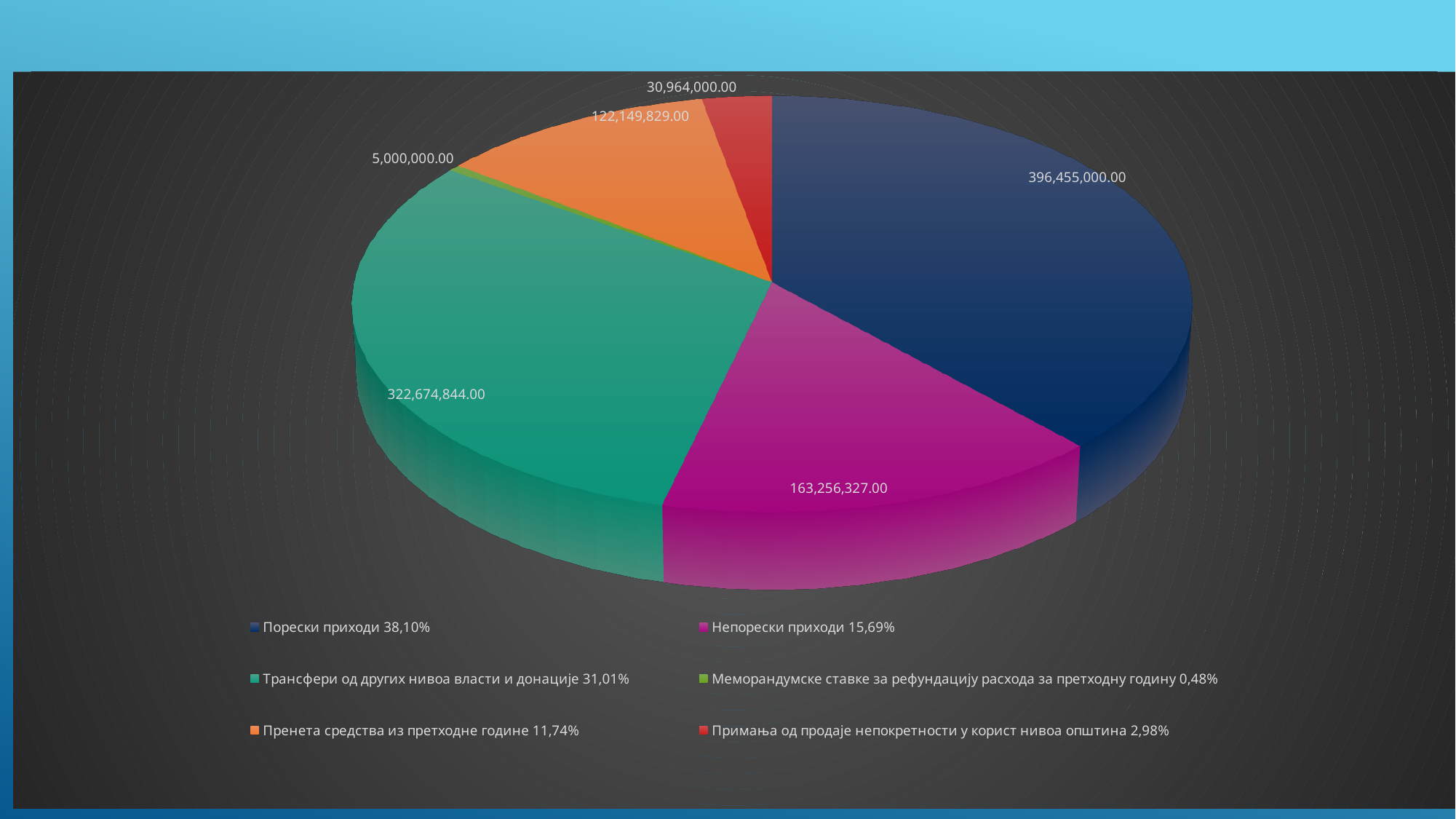
Which is larger: Непорески приходи or Пренета средства из претходне године? Непорески приходи What kind of chart is shown on the slide? pie chart What share of the pie does Непорески приходи represent, according to the legend? 15,69% What is the value of the Порески приходи slice? 396,455,000.00 What is the difference between the Порески приходи value and the Трансфери од других нивоа власти и донације value? 73,780,156.00 Which category has the largest slice of the pie? Порески приходи What colour is the Примања од продаје непокретности у корист нивоа општина slice? red Which category has the smallest slice of the pie? Меморандумске ставке за рефундацију расхода за претходну годину What is the value of the Пренета средства из претходне године slice? 122,149,829.00 What is the value of the Трансфери од других нивоа власти и донације slice? 322,674,844.00 How many slices does the pie chart have? 6 What is the value of the Меморандумске ставке за рефундацију расхода за претходну годину slice? 5,000,000.00